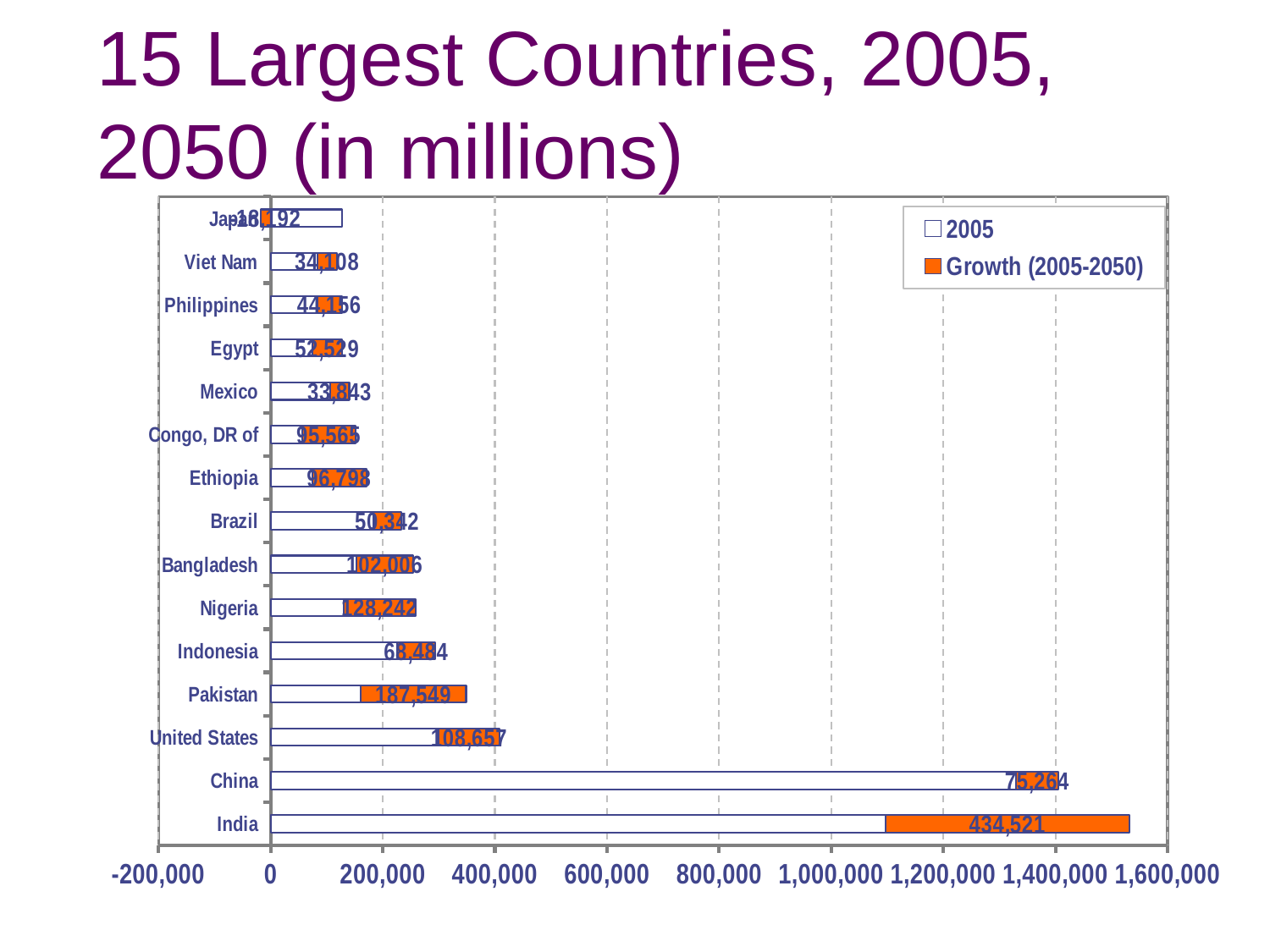
How many series does the legend list? 2 What is the Growth (2005-2050) value for India? 434,521 How many countries are shown in the chart? 15 Is the 2005 value for China greater or less than 1,200,000? greater Which has the larger Growth (2005-2050) value, Pakistan or Nigeria? Pakistan What is the difference between the Growth (2005-2050) values for Pakistan and the United States? 78,892 What kind of chart is shown on the slide? bar chart What is the Growth (2005-2050) value for Nigeria? 128,242 Which country has the largest Growth (2005-2050) value? India What is the Growth (2005-2050) value for Pakistan? 187,549 What is the Growth (2005-2050) value for the United States? 108,657 What is the difference between the Growth (2005-2050) values for India and China? 359,257